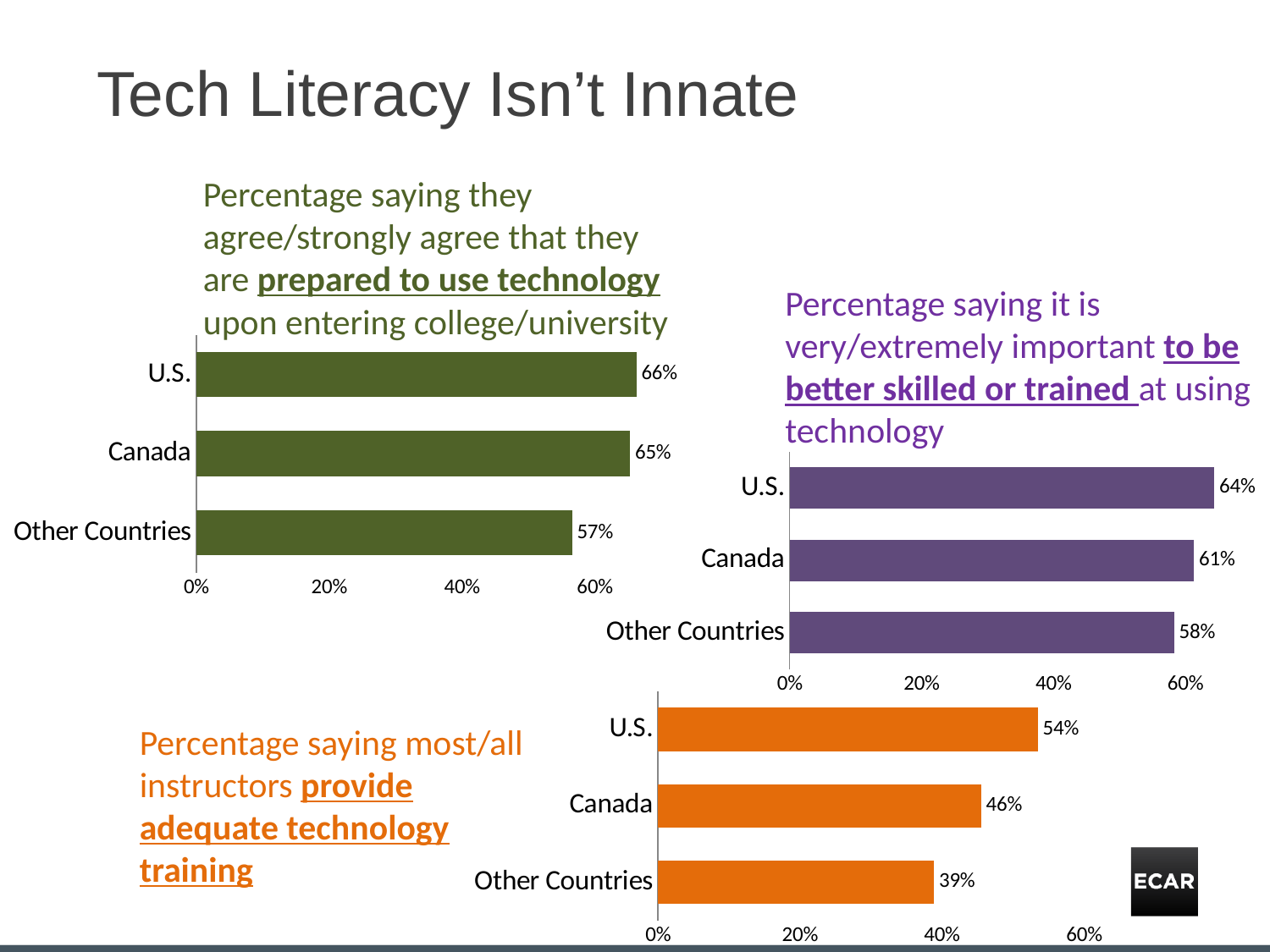
What kind of chart is the 'prepared to use technology' chart (top left)? bar chart In the 'provide adequate technology training' chart (bottom), what is the value for Other Countries? 39% In the 'better skilled or trained' chart (top right), which category has the highest value? U.S. In the 'prepared to use technology' chart (top left), which category has the lowest value? Other Countries In the 'better skilled or trained' chart (top right), what is the value for the U.S.? 64% In the 'better skilled or trained' chart (top right), what is the difference between Canada and Other Countries? 3% In the 'prepared to use technology' chart (top left), what is the difference between the U.S. and Other Countries values? 9% In the 'provide adequate technology training' chart (bottom), is the value for Other Countries greater or less than 40%? less What colour are the bars in the 'better skilled or trained' chart (top right)? purple In the 'provide adequate technology training' chart (bottom), which is larger, the value for the U.S. or for Canada? U.S. In the 'prepared to use technology' chart (top left), what is the value for Canada? 65% How many categories are shown in the 'provide adequate technology training' chart (bottom)? 3